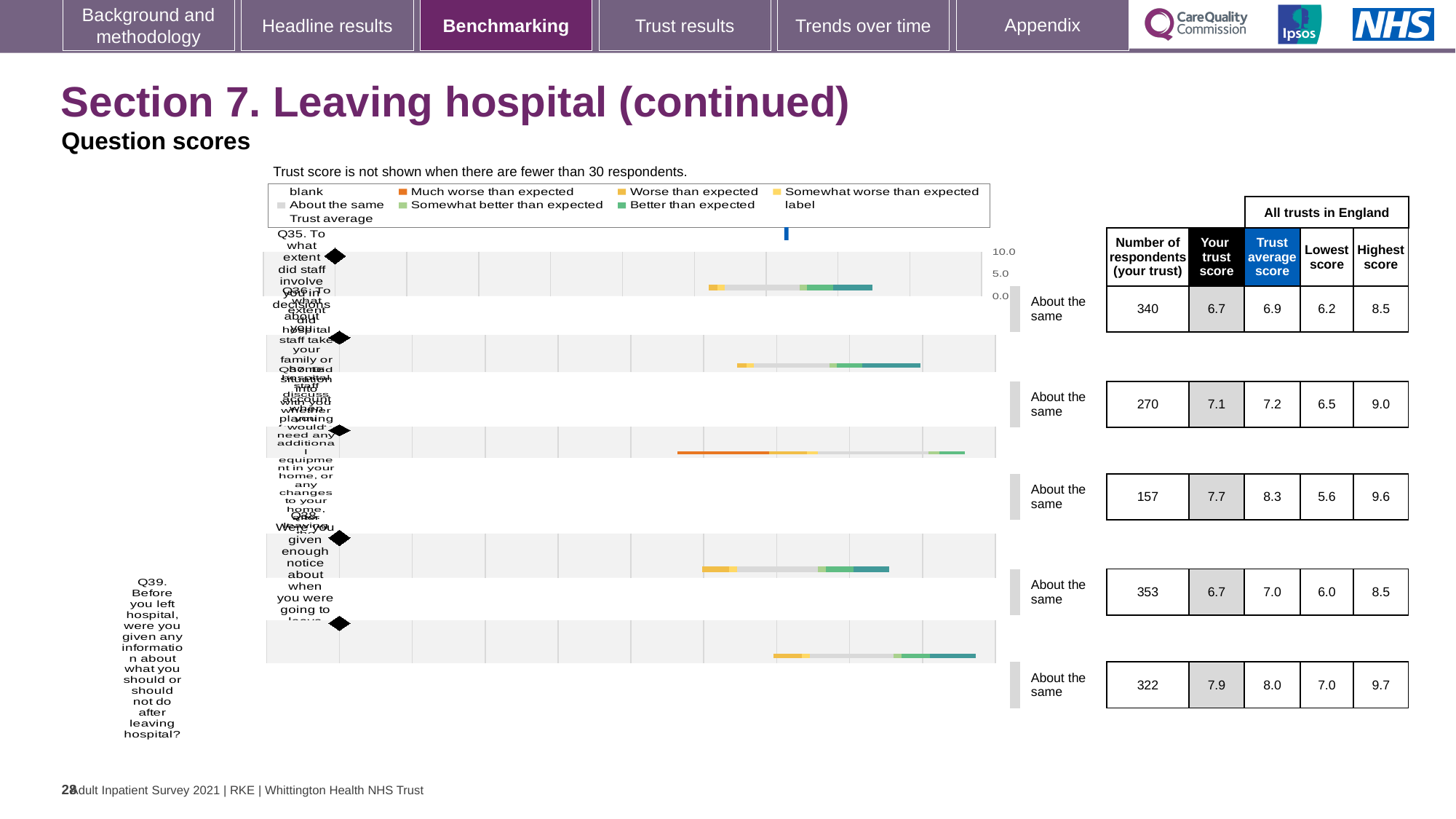
What is the trust score for Q35 (the first row of the chart)? 6.7 What is the number of respondents for Q35 (the first row of the chart)? 340 What is the difference between the trust average score and your trust score for the third row of the chart? 0.6 How many question rows are shown in the benchmarking chart on this slide? 5 Which row of the chart has the highest 'Your trust score'? Q39, the last row (7.9) What benchmark category is shown for every question row on this chart? About the same What is the trust average score for Q39 (the last row of the chart)? 8.0 Is your trust score for Q35 (the first row) greater or less than 5.0 on the chart axis? greater What is the lowest score across all trusts in England for the third row of the chart? 5.6 Which row of the chart has the lowest number of respondents? The third row (157 respondents) Which is larger for the fourth row of the chart: your trust score or the trust average score? Trust average score (7.0) What is the highest score across all trusts in England for Q39 (the last row of the chart)? 9.7